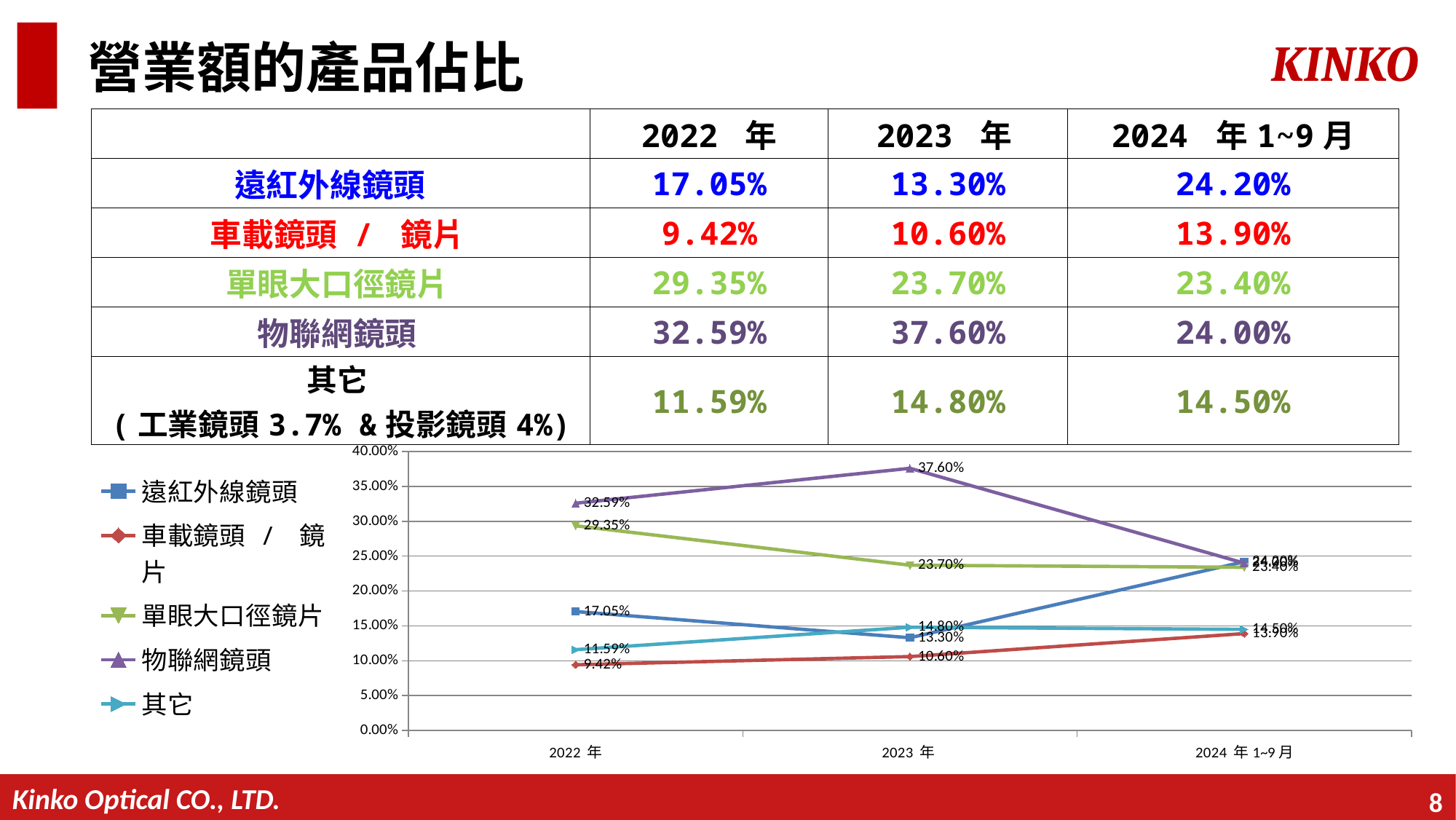
How many series does the chart legend list? 5 Which is larger in 2022 年, 單眼大口徑鏡片 or 遠紅外線鏡頭? 單眼大口徑鏡片 What is the value for 遠紅外線鏡頭 in 2022 年? 17.05% What is the value for 車載鏡頭 / 鏡片 in 2024 年 1~9 月? 13.90% Which series has the lowest value in 2023 年? 車載鏡頭 / 鏡片 Does the 車載鏡頭 / 鏡片 series rise or fall from 2022 年 to 2024 年 1~9 月? rise How many points are on the x axis of the chart? 3 What is the value for 物聯網鏡頭 in 2023 年? 37.60% What colour is the 物聯網鏡頭 line in the chart? purple What kind of chart is shown on the slide? line chart What is the difference between the 物聯網鏡頭 values in 2023 年 and 2024 年 1~9 月? 13.60% Which series has the highest value in 2022 年? 物聯網鏡頭